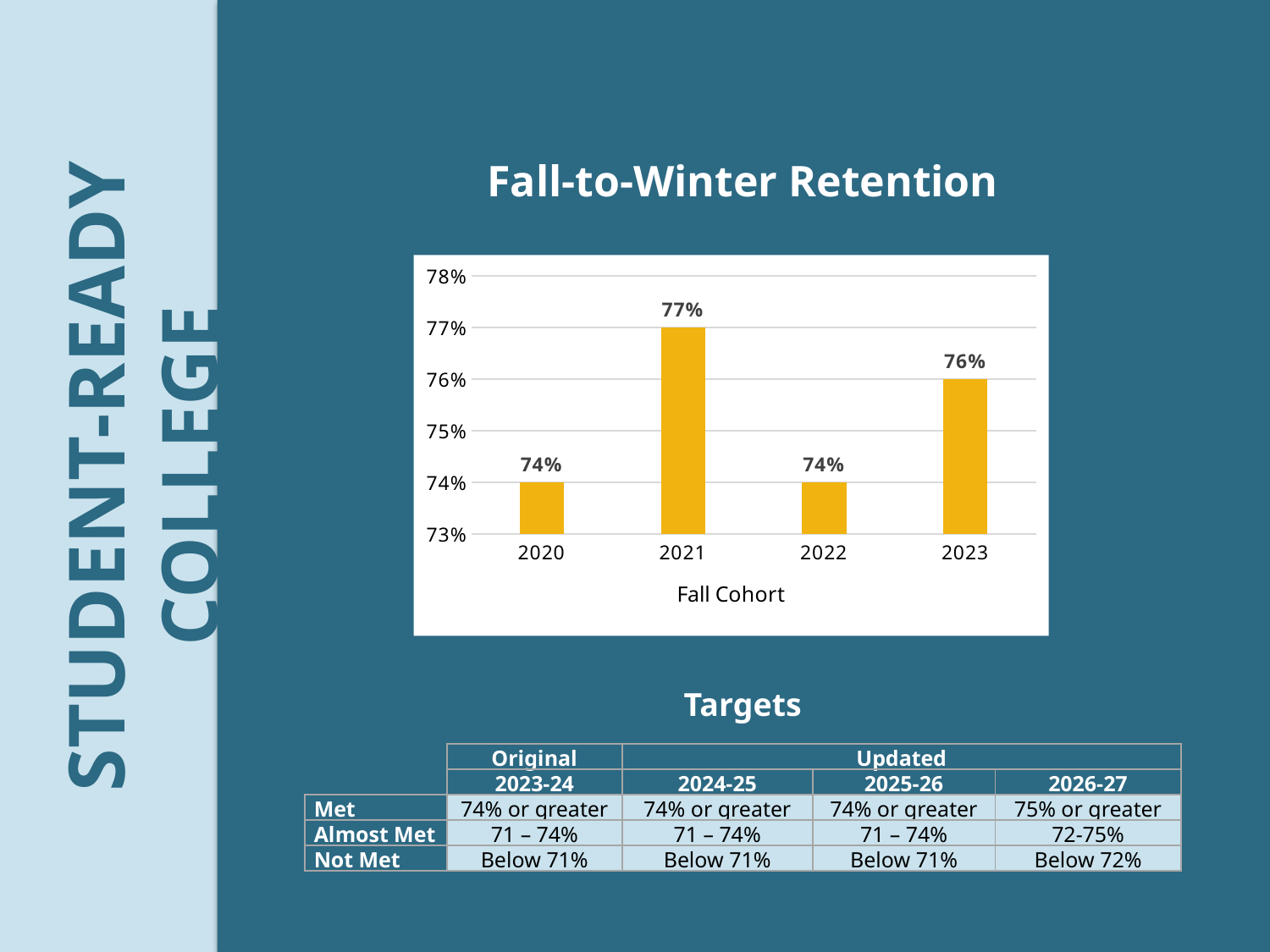
What is the Fall-to-Winter Retention value for the 2023 fall cohort? 76% Which fall cohort has the highest Fall-to-Winter Retention? 2021 What is the Fall-to-Winter Retention value for the 2020 fall cohort? 74% Which has a higher Fall-to-Winter Retention, the 2021 cohort or the 2023 cohort? 2021 What kind of chart is used to show Fall-to-Winter Retention? Bar chart Is the Fall-to-Winter Retention for the 2021 cohort greater or less than 75%? greater How many fall cohorts are shown in the Fall-to-Winter Retention chart? 4 What is the x-axis label of the Fall-to-Winter Retention chart? Fall Cohort What is the title of the chart on the slide? Fall-to-Winter Retention What is the Fall-to-Winter Retention value for the 2021 fall cohort? 77% What is the difference in Fall-to-Winter Retention between the 2023 and 2020 cohorts? 2% What is the difference in Fall-to-Winter Retention between the 2021 and 2022 cohorts? 3%